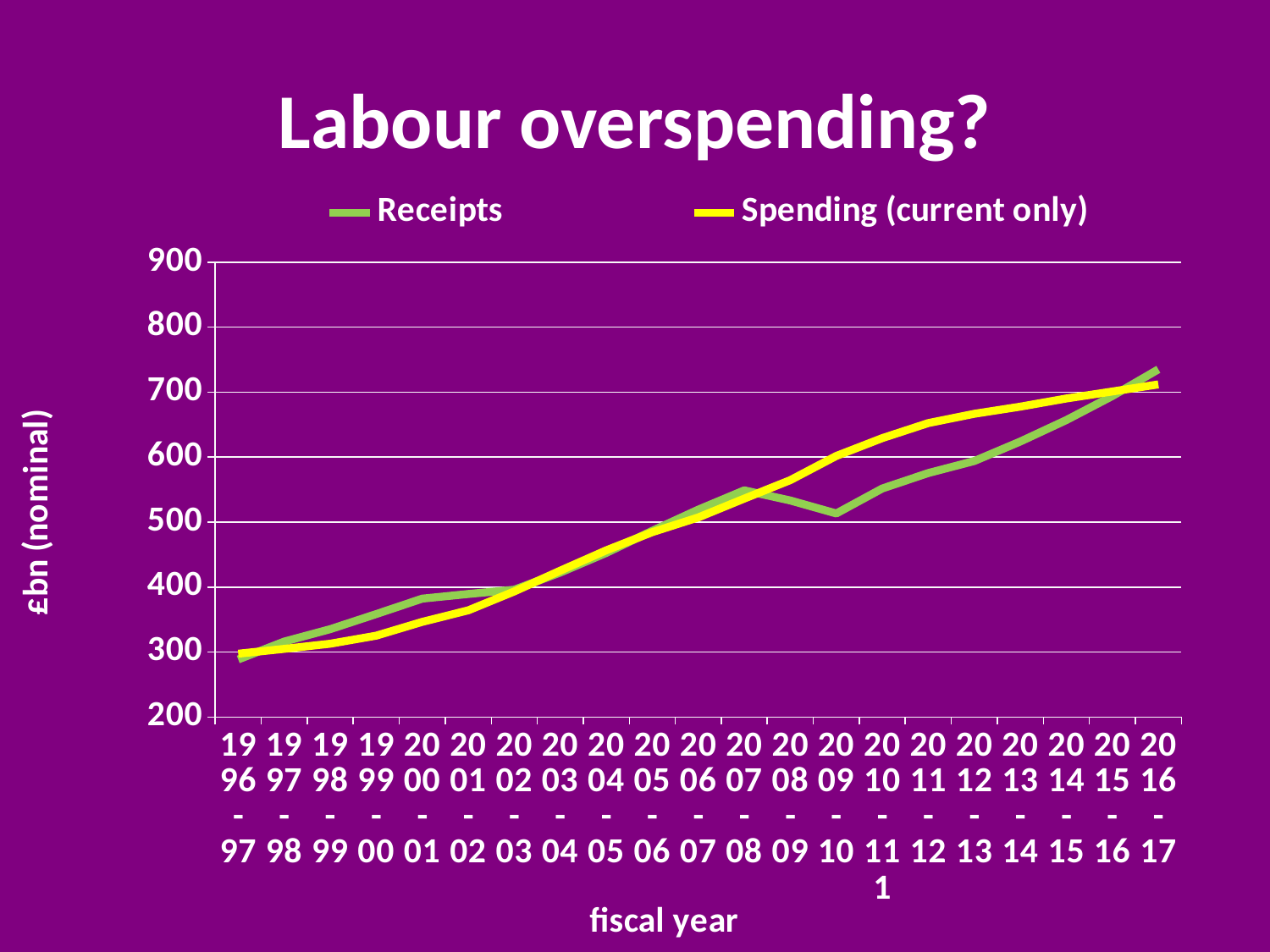
How many fiscal years are plotted along the x axis? 21 What is the title of the chart? Labour overspending? How many series does the legend list? 2 Which fiscal year has the lowest value for Spending (current only)? 1996-97 Which fiscal year has the highest value for Receipts? 2016-17 What is the label on the y axis? £bn (nominal) Is the value for Spending (current only) in 2000-01 greater or less than 400? less In 2000-01, which is larger: Receipts or Spending (current only)? Receipts Is the value for Spending (current only) in 2011-12 greater or less than 600? greater What kind of chart is shown on the slide? line chart In 2009-10, which is larger: Receipts or Spending (current only)? Spending (current only) Is the value for Receipts in 2016-17 greater or less than 700? greater